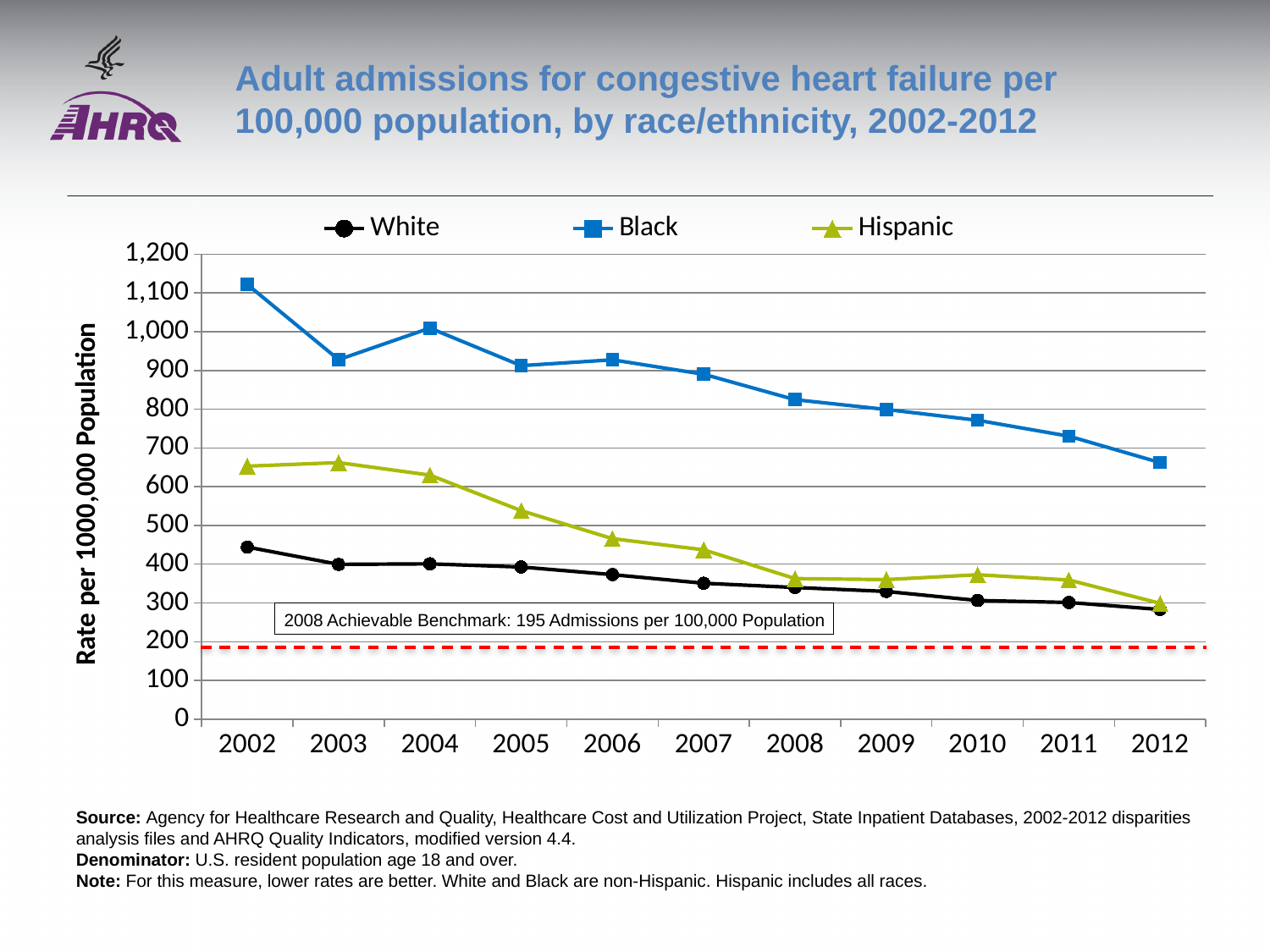
Is the value for Black in 2012 greater or less than 600? greater Is the value for Black in 2010 greater or less than 800? less Does the admission rate for Black adults rise or fall from 2002 to 2012? fall In 2006, which is larger, the value for Hispanic or the value for White? Hispanic Is the value for Hispanic in 2005 greater or less than 500? greater What is the 2008 achievable benchmark shown on the chart, in admissions per 100,000 population? 195 How many years are plotted along the x axis? 11 Which race/ethnicity group has the highest admission rate in 2002? Black Which race/ethnicity group has the lowest admission rate in 2002? White How many series does the legend list? 3 What kind of chart is shown on the slide? line chart